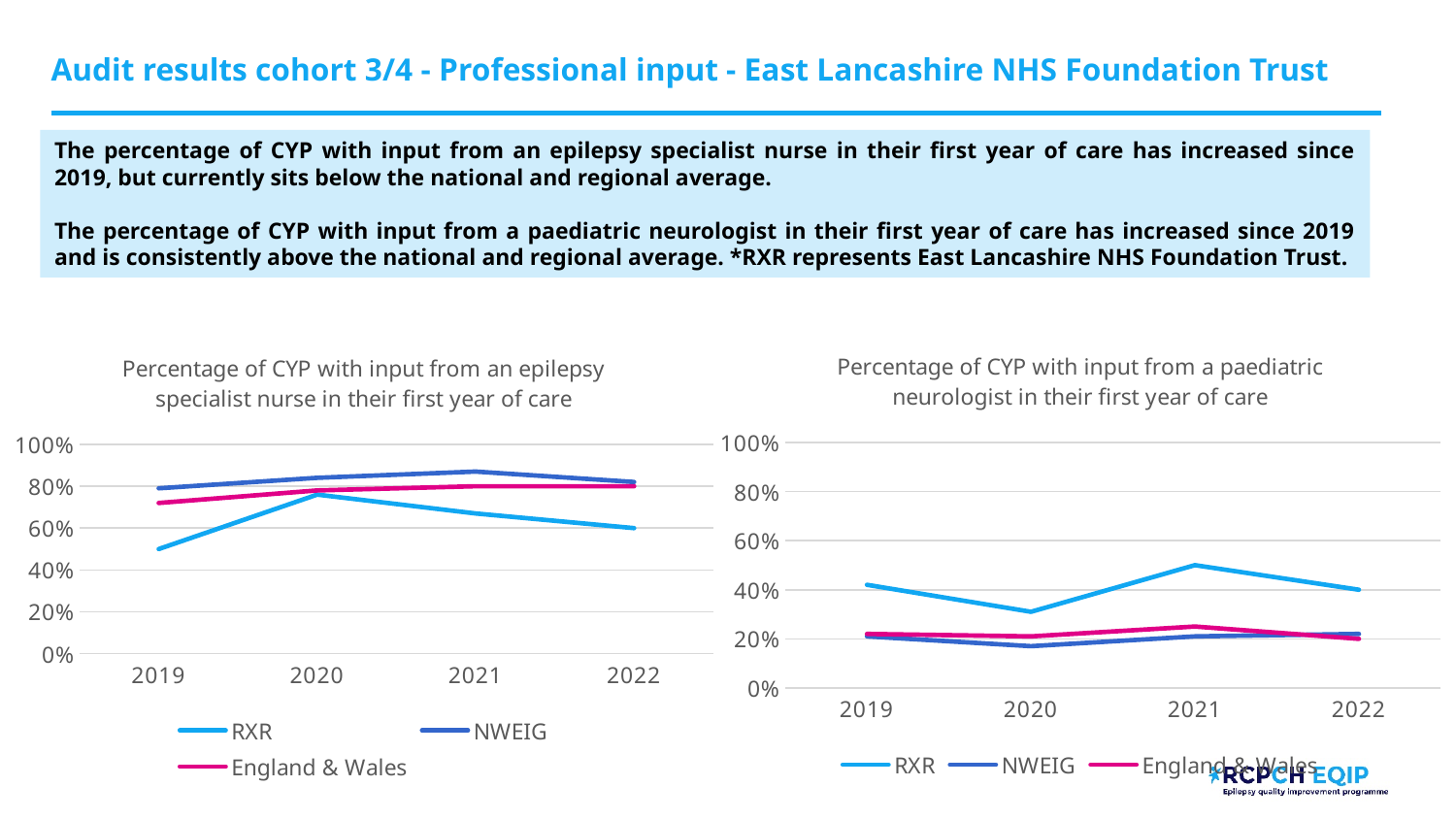
On the 'Percentage of CYP with input from an epilepsy specialist nurse in their first year of care' chart, in which year is the RXR value highest? 2020 How many series does the legend list on the 'Percentage of CYP with input from a paediatric neurologist in their first year of care' chart? 3 Which series is drawn in pink on the 'Percentage of CYP with input from a paediatric neurologist in their first year of care' chart? England & Wales On the 'Percentage of CYP with input from an epilepsy specialist nurse in their first year of care' chart, is the value for NWEIG in 2021 greater or less than 80%? greater On the 'Percentage of CYP with input from a paediatric neurologist in their first year of care' chart, in which year is the RXR value lowest? 2020 On the 'Percentage of CYP with input from a paediatric neurologist in their first year of care' chart, in which year is the RXR value highest? 2021 What kind of chart is the 'Percentage of CYP with input from an epilepsy specialist nurse in their first year of care' chart? Line chart On the 'Percentage of CYP with input from an epilepsy specialist nurse in their first year of care' chart, which is larger in 2019: RXR or NWEIG? NWEIG On the 'Percentage of CYP with input from an epilepsy specialist nurse in their first year of care' chart, does the RXR line rise or fall from 2020 to 2022? Fall On the 'Percentage of CYP with input from a paediatric neurologist in their first year of care' chart, is the value for RXR in 2020 greater or less than 40%? less How many years are shown on the x axis of the 'Percentage of CYP with input from an epilepsy specialist nurse in their first year of care' chart? 4 On the 'Percentage of CYP with input from an epilepsy specialist nurse in their first year of care' chart, is the value for RXR in 2019 greater or less than 60%? less